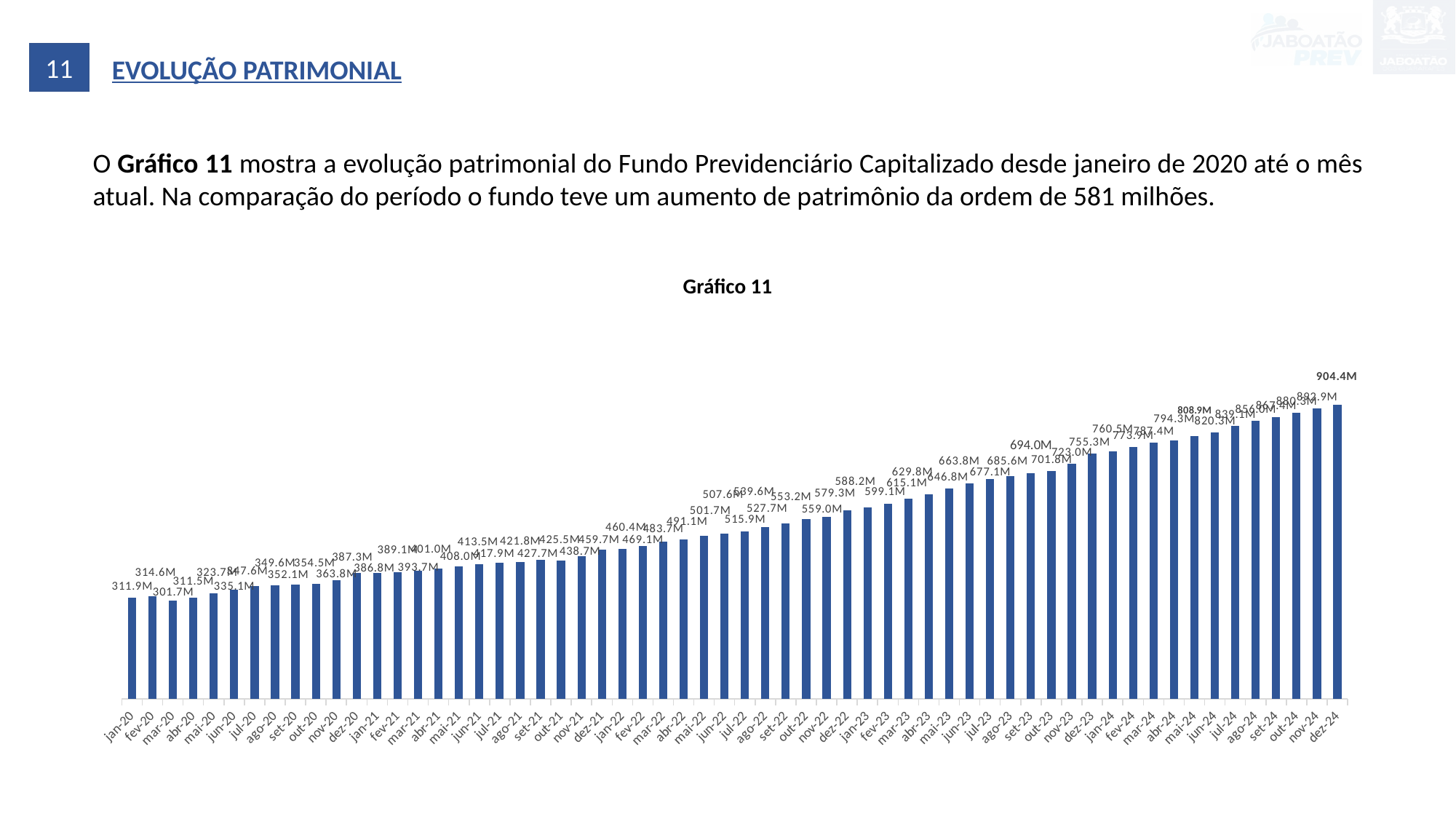
How many monthly bars are plotted in Gráfico 11? 60 Which is larger in Gráfico 11, the value for jun-23 or the value for jun-22? jun-23 Do the values in Gráfico 11 generally rise or fall from jan-20 to dez-24? rise What is the difference between the values for dez-24 and nov-24 in Gráfico 11? 11.5M What is the value shown for dez-23 in Gráfico 11? 755.3M What is the difference between the values for dez-23 and dez-22 in Gráfico 11? 176.0M What is the value shown for jan-20 in Gráfico 11? 311.9M What is the value shown for dez-24 in Gráfico 11? 904.4M Which month has the highest value in Gráfico 11? dez-24 What type of chart is Gráfico 11? bar chart What is the value shown for set-23 in Gráfico 11? 694.0M Which month has the lowest value in Gráfico 11? mar-20